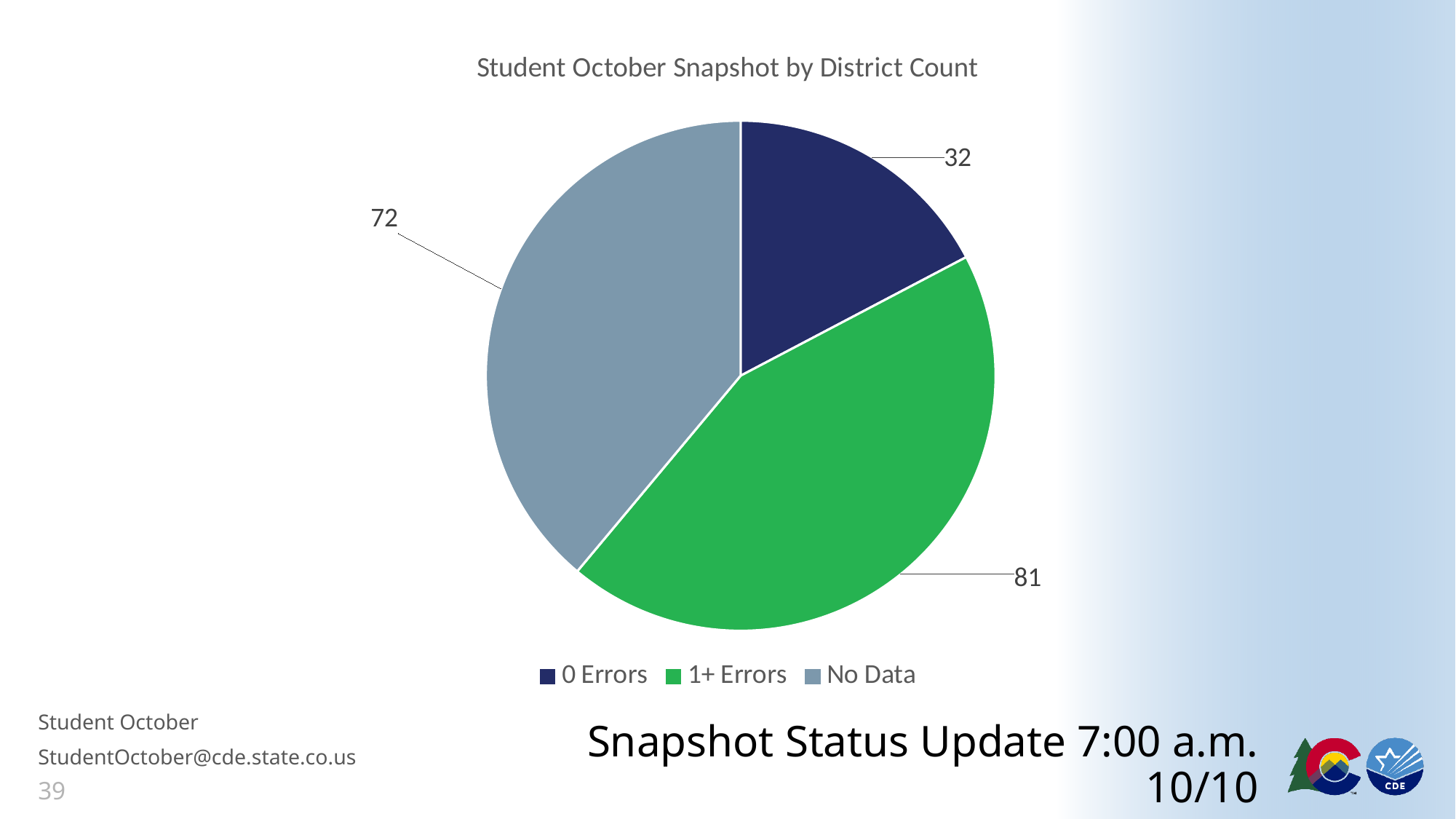
How many categories does the pie chart show? 3 What is the value for No Data? 72 Which category has the smallest slice? 0 Errors What is the value for 1+ Errors? 81 What is the total of all slices in the pie chart? 185 What is the value for 0 Errors? 32 What is the difference between the No Data value and the 0 Errors value? 40 Which is larger, the value for No Data or the value for 0 Errors? No Data What is the difference between the 1+ Errors value and the No Data value? 9 What is the title of the chart? Student October Snapshot by District Count Which category has the largest slice? 1+ Errors What kind of chart is shown on the slide? Pie chart